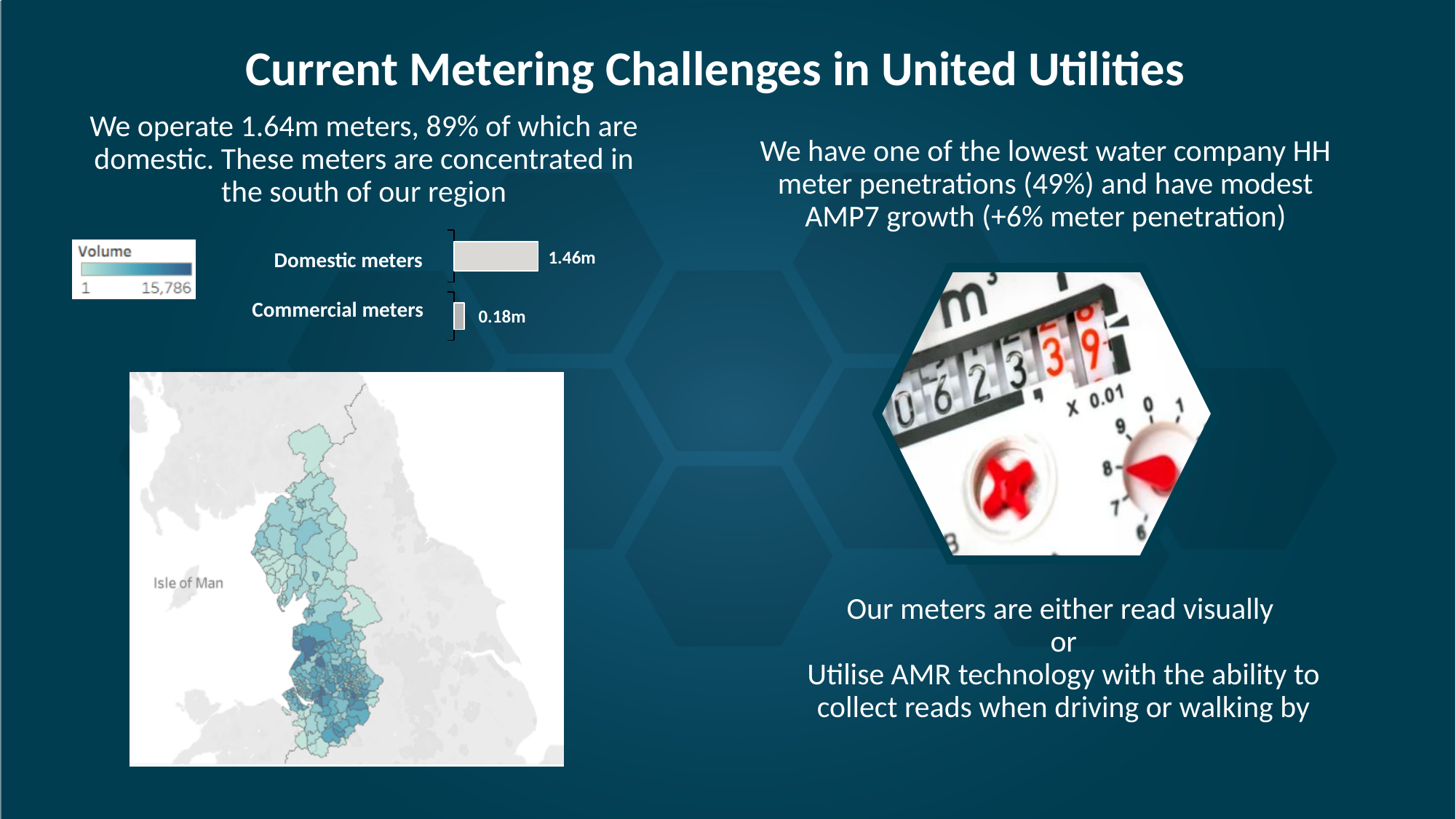
In the bar chart, which category has the highest value? Domestic meters In the bar chart, what is the value for Domestic meters? 1.46m In the bar chart, what is the difference between Domestic meters and Commercial meters? 1.28m In the bar chart, are the bars drawn horizontally or vertically? Horizontally How many categories does the bar chart show? 2 In the bar chart, which is larger: Domestic meters or Commercial meters? Domestic meters In the bar chart, what is the value for Commercial meters? 0.18m On the map's Volume legend, what is the highest value shown? 15,786 What kind of chart shows the Domestic and Commercial meter figures? Bar chart In the bar chart, which category has the lowest value? Commercial meters